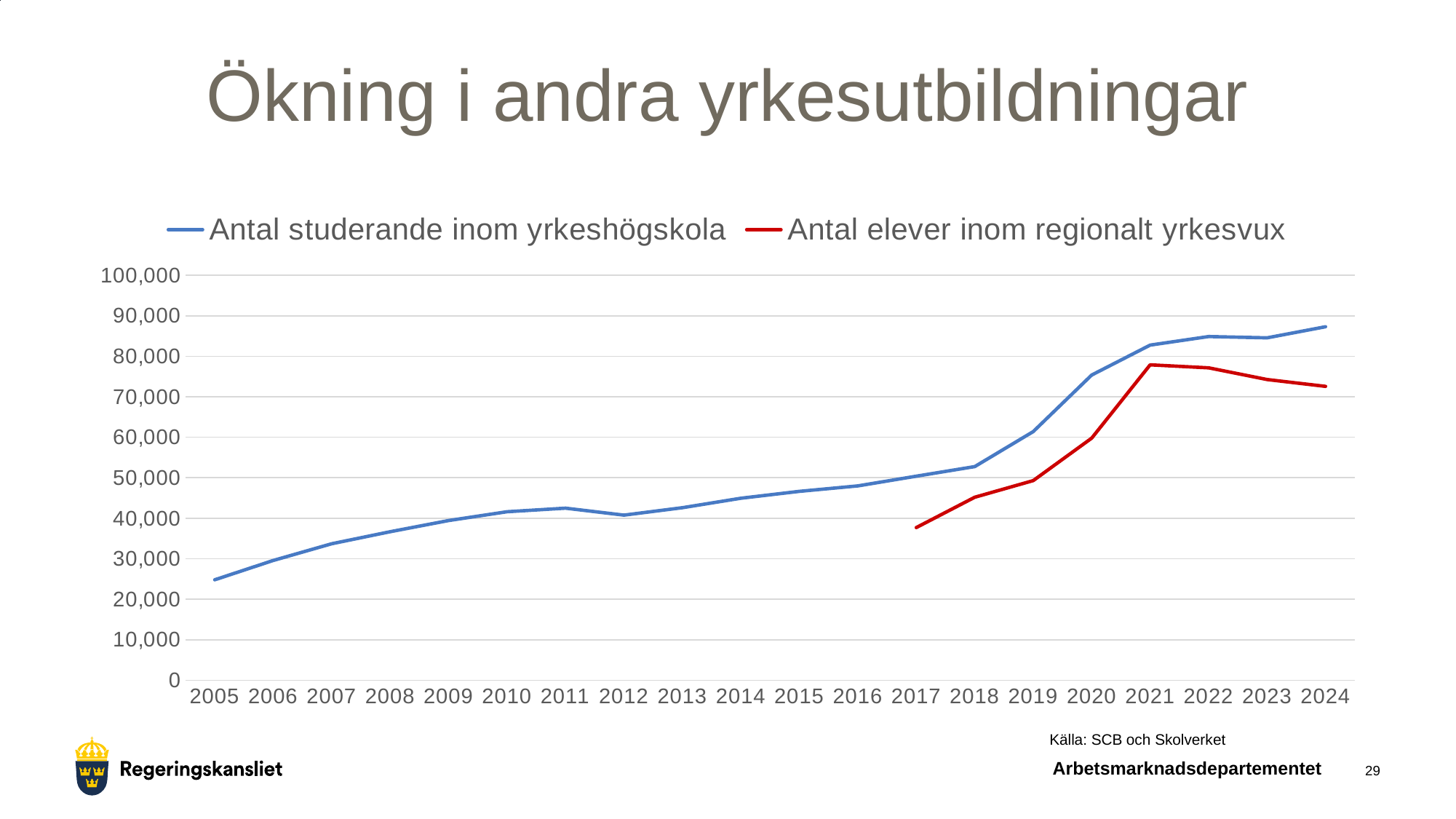
Does the value for 'Antal elever inom regionalt yrkesvux' rise or fall from 2021 to 2024? fall What kind of chart is shown on the slide? line chart Which colour is used for the series 'Antal elever inom regionalt yrkesvux'? red What is the title of the slide? Ökning i andra yrkesutbildningar In which year is the value for 'Antal studerande inom yrkeshögskola' highest? 2024 How many series does the legend list? 2 Is the value for 'Antal studerande inom yrkeshögskola' in 2005 greater or less than 30,000? less How many years are shown on the x axis? 20 Is the value for 'Antal elever inom regionalt yrkesvux' in 2021 greater or less than 70,000? greater In 2024, which series has the larger value, 'Antal studerande inom yrkeshögskola' or 'Antal elever inom regionalt yrkesvux'? Antal studerande inom yrkeshögskola In which year is the value for 'Antal elever inom regionalt yrkesvux' highest? 2021 In which year is the value for 'Antal studerande inom yrkeshögskola' lowest? 2005